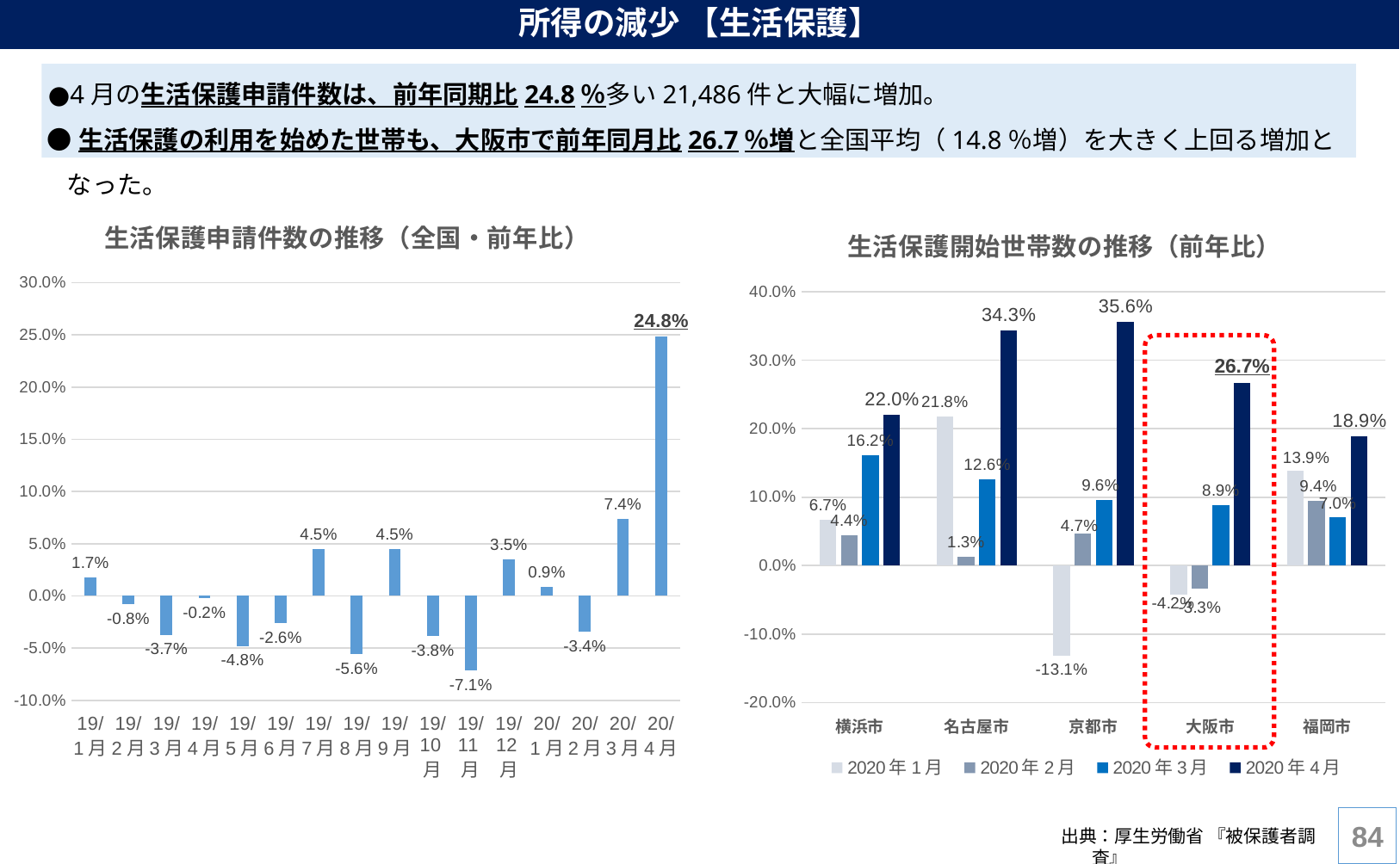
In the right chart (生活保護開始世帯数の推移), which city is highlighted with a red dotted box? 大阪市 In the right chart (生活保護開始世帯数の推移), how many series does the legend list? 4 In the right chart (生活保護開始世帯数の推移), what is the value for 京都市 in 2020年1月? -13.1% In the right chart (生活保護開始世帯数の推移), what is the value for 大阪市 in 2020年4月? 26.7% In the left chart (生活保護申請件数の推移), what is the value for 20/4月? 24.8% In the left chart (生活保護申請件数の推移), what kind of chart is shown? Bar chart In the left chart (生活保護申請件数の推移), what is the value for 19/11月? -7.1% In the right chart (生活保護開始世帯数の推移), which is larger: 名古屋市 in 2020年4月 or 横浜市 in 2020年4月? 名古屋市 In the left chart (生活保護申請件数の推移), what is the difference between the values for 20/4月 and 20/3月? 17.4 percentage points In the left chart (生活保護申請件数の推移), how many months are plotted? 16 In the left chart (生活保護申請件数の推移), which month has the lowest value? 19/11月 In the right chart (生活保護開始世帯数の推移), which city has the highest value for 2020年4月? 京都市